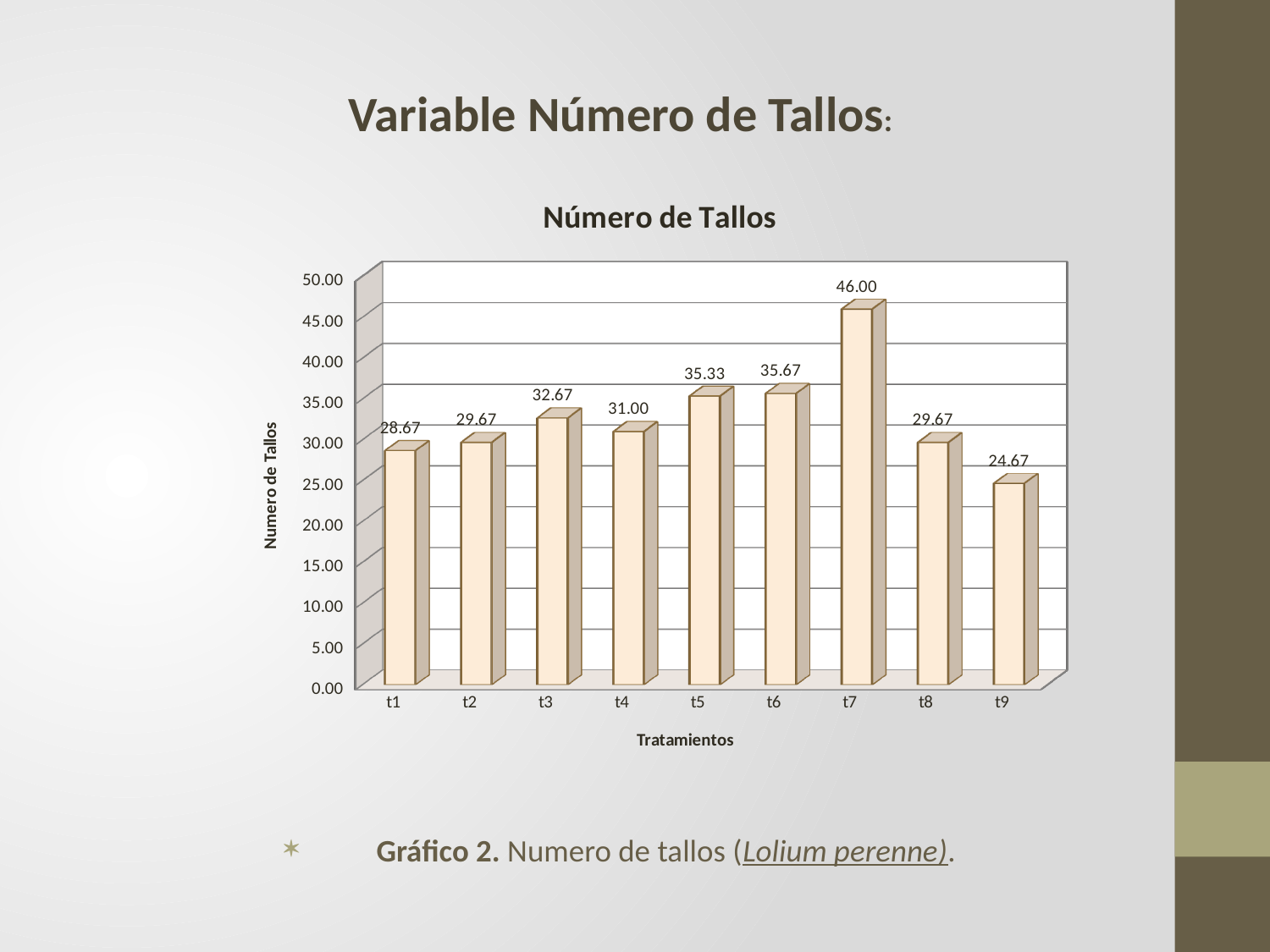
Which treatment has the lowest number of tallos? t9 What is the difference between the values for t7 and t9? 21.33 What is the value for t7? 46.00 Is the value for t6 greater or less than 30.00? greater How many treatments are shown on the x axis? 9 What kind of chart is this? bar chart What is the value for t1? 28.67 Which treatment has the highest number of tallos? t7 What is the label of the x axis? Tratamientos What is the value for t5? 35.33 Which is larger, the value for t3 or the value for t4? t3 What is the title of the chart? Número de Tallos